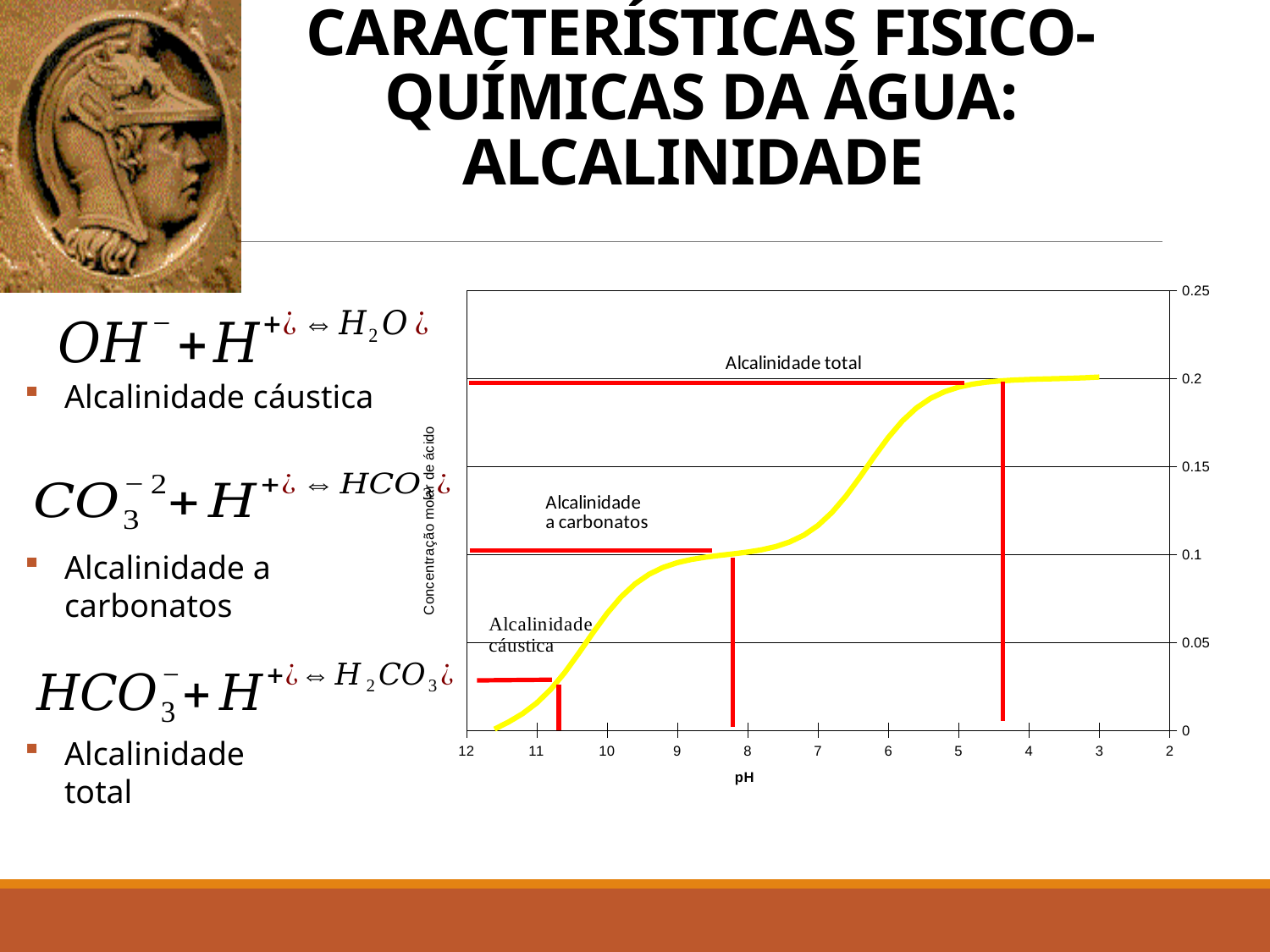
What is the highest value shown on the y axis of the chart? 0.25 At which y-axis value is the red horizontal line labelled 'Alcalinidade a carbonatos' drawn? 0.1 What is the label of the x axis of the chart? pH At which y-axis value is the red horizontal line labelled 'Alcalinidade total' drawn? 0.2 Is the value of the yellow curve at pH 11 greater or less than 0.05? less What kind of chart is shown on the slide? line chart Does the yellow curve rise or fall from left to right along the x axis? rise Is the value of the yellow curve at pH 3 greater or less than 0.15? greater Which has the larger value on the yellow curve, pH 5 or pH 9? pH 5 What is the label of the y axis of the chart? Concentração molar de ácido Is the value of the yellow curve at pH 5 greater or less than 0.15? greater